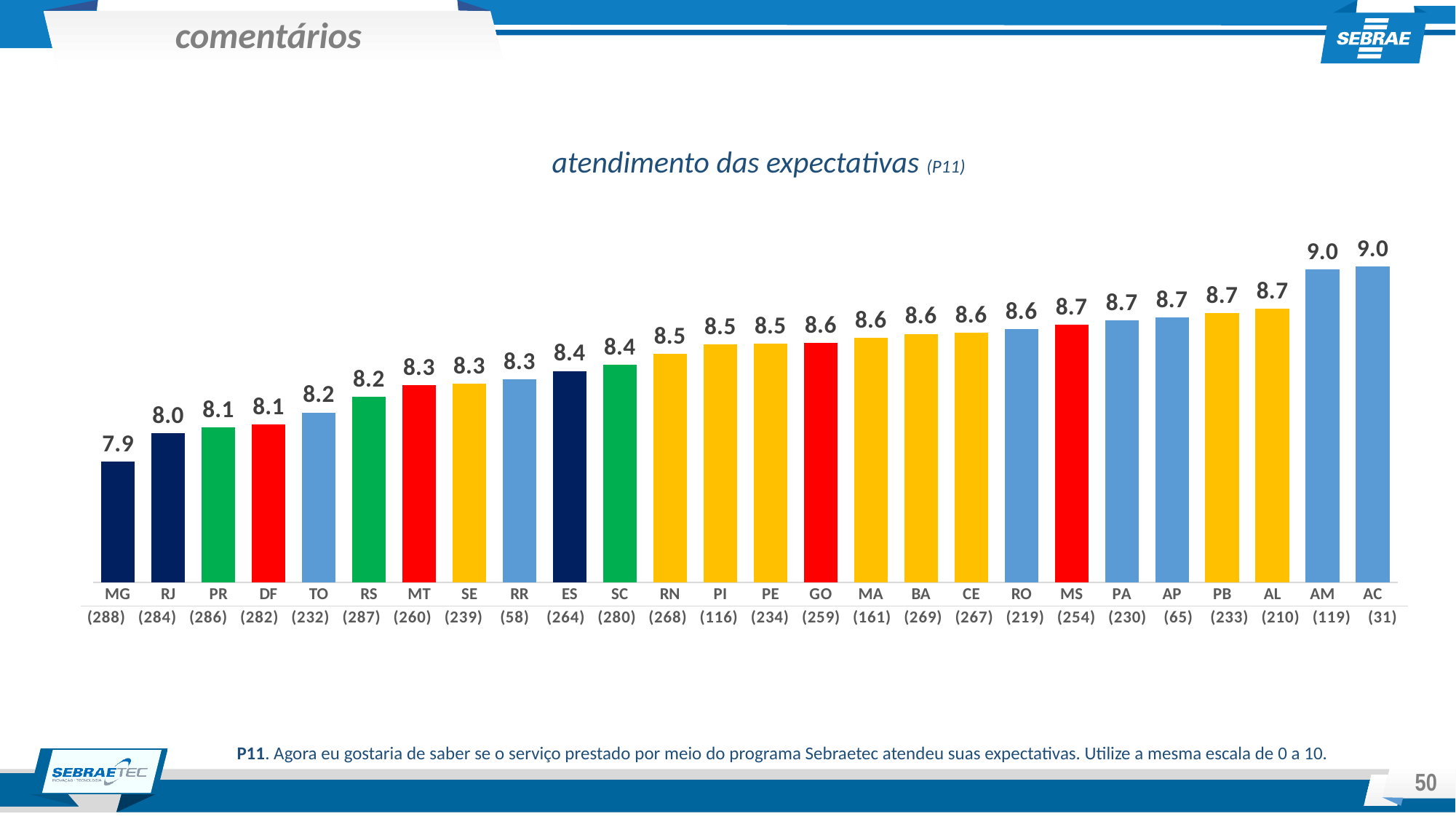
Which category has the lowest value? MG What is the difference between the values for AC and MG? 1.1 What is the title of the chart? atendimento das expectativas (P11) What is the value for GO? 8.6 What is the difference between the values for GO and MG? 0.7 What is the value for MS? 8.7 What is the value for RR? 8.3 What is the value for TO? 8.2 Do the values rise or fall from left to right along the x axis? rise How many categories (states) are plotted in the chart? 26 What type of chart is shown on the slide? bar chart Which has a larger value, RS or SC? SC